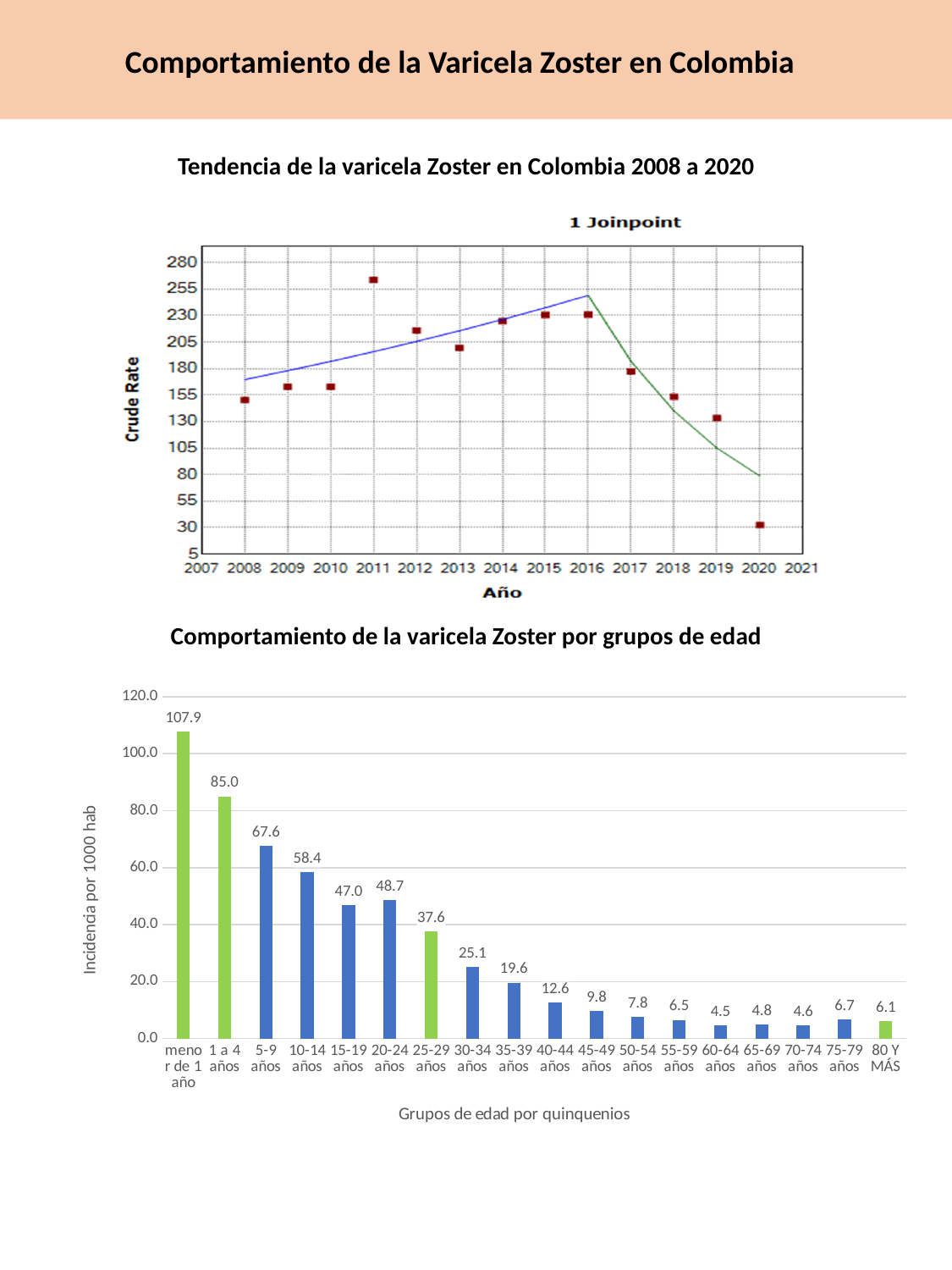
In the top chart 'Tendencia de la varicela Zoster en Colombia 2008 a 2020', is the crude rate for 2011 greater or less than 230? greater In the top chart 'Tendencia de la varicela Zoster en Colombia 2008 a 2020', is the crude rate for 2020 greater or less than 55? less In the bottom chart 'Comportamiento de la varicela Zoster por grupos de edad', which has the higher incidence, 15-19 años or 20-24 años? 20-24 años In the bottom chart 'Comportamiento de la varicela Zoster por grupos de edad', which age group has the lowest incidence? 60-64 años In the bottom chart 'Comportamiento de la varicela Zoster por grupos de edad', what is the difference between the incidence for menor de 1 año and 1 a 4 años? 22.9 In the bottom chart 'Comportamiento de la varicela Zoster por grupos de edad', which age group has the highest incidence? menor de 1 año What kind of chart is the bottom chart 'Comportamiento de la varicela Zoster por grupos de edad'? Bar chart In the bottom chart 'Comportamiento de la varicela Zoster por grupos de edad', what is the incidence for the 5-9 años group? 67.6 In the bottom chart 'Comportamiento de la varicela Zoster por grupos de edad', what is the incidence for the 80 Y MÁS group? 6.1 In the bottom chart 'Comportamiento de la varicela Zoster por grupos de edad', how many age groups are shown? 18 In the top chart 'Tendencia de la varicela Zoster en Colombia 2008 a 2020', how many years have data points plotted? 13 In the top chart 'Tendencia de la varicela Zoster en Colombia 2008 a 2020', what is the label of the y axis? Crude Rate